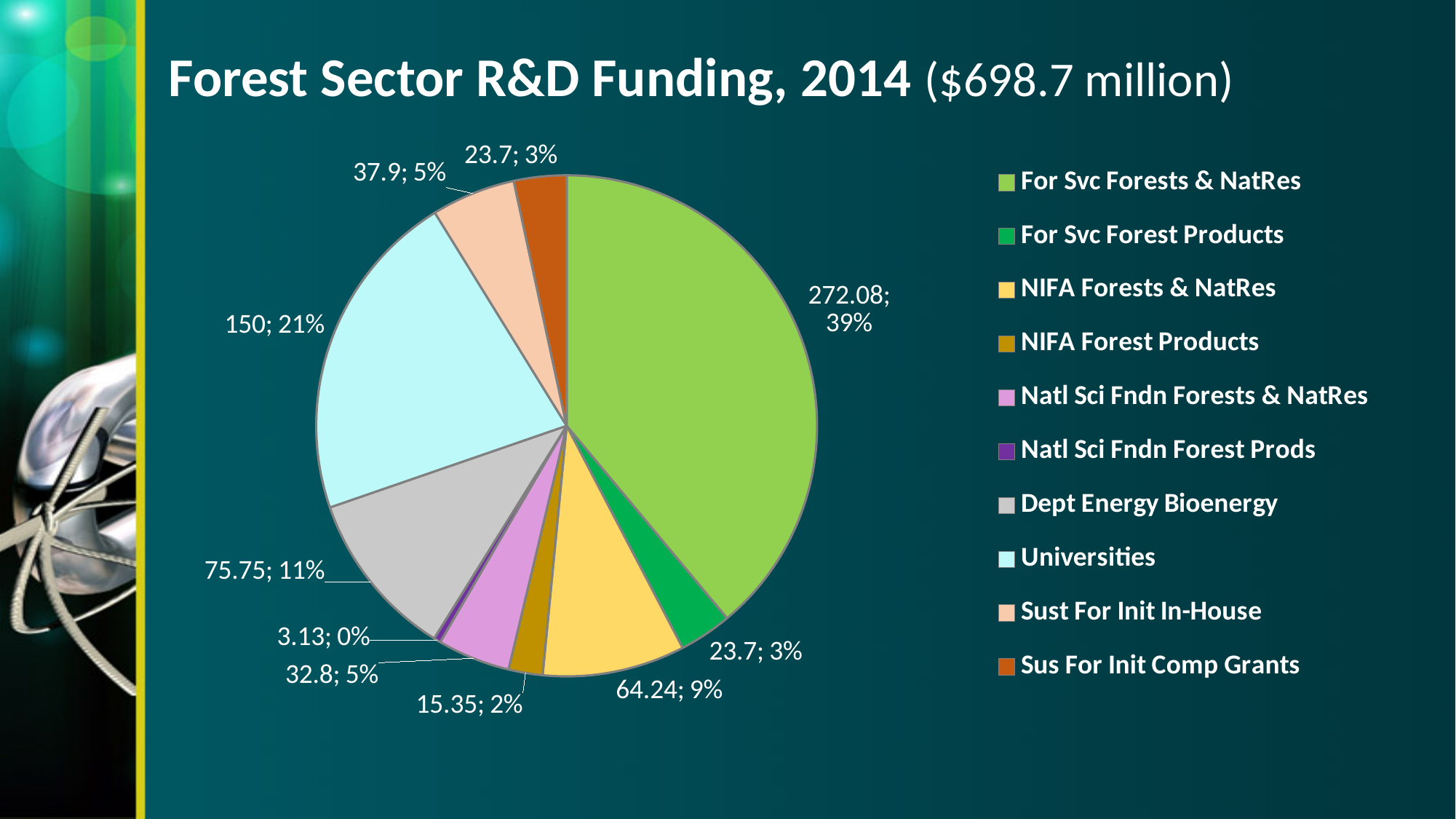
What kind of chart is shown on the slide? pie chart What share of the pie does NIFA Forests & NatRes represent? 9% What is the value for NIFA Forest Products? 15.35 What is the difference between the values for Universities and Dept Energy Bioenergy? 74.25 Which category has the smallest slice? Natl Sci Fndn Forest Prods What share of the pie does For Svc Forests & NatRes represent? 39% How many categories does the legend list? 10 What is the value for Dept Energy Bioenergy? 75.75 Which is larger, the value for Sust For Init In-House or the value for Natl Sci Fndn Forests & NatRes? Sust For Init In-House What total funding amount is given in the chart title? $698.7 million Which category has the largest slice? For Svc Forests & NatRes What is the value for Universities? 150